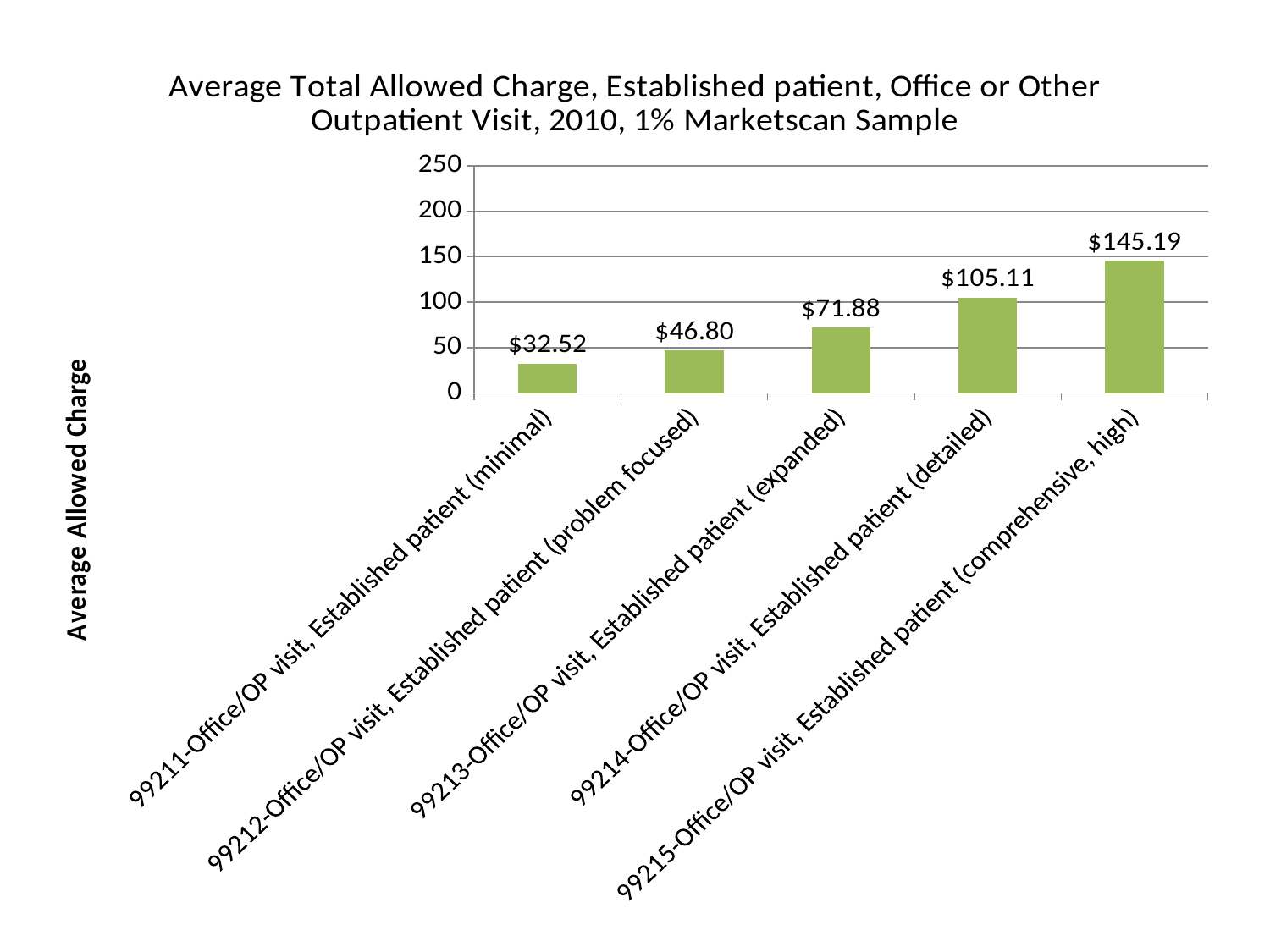
What is the difference in average allowed charge between 99214 (detailed) and 99212 (problem focused)? $58.31 Which visit code has the highest average allowed charge? 99215-Office/OP visit, Established patient (comprehensive, high) What is the average allowed charge for 99215-Office/OP visit, Established patient (comprehensive, high)? $145.19 What is the label of the vertical axis? Average Allowed Charge What kind of chart is shown on the slide? Bar chart What is the average allowed charge for 99213-Office/OP visit, Established patient (expanded)? $71.88 Is the value for 99214-Office/OP visit, Established patient (detailed) greater or less than 100? greater What is the average allowed charge for 99211-Office/OP visit, Established patient (minimal)? $32.52 Which visit code has the lowest average allowed charge? 99211-Office/OP visit, Established patient (minimal) How many visit codes are shown on the chart? 5 Which has a larger average allowed charge, 99213 (expanded) or 99214 (detailed)? 99214-Office/OP visit, Established patient (detailed) Do the average allowed charges rise or fall from 99211 to 99215 along the x axis? Rise